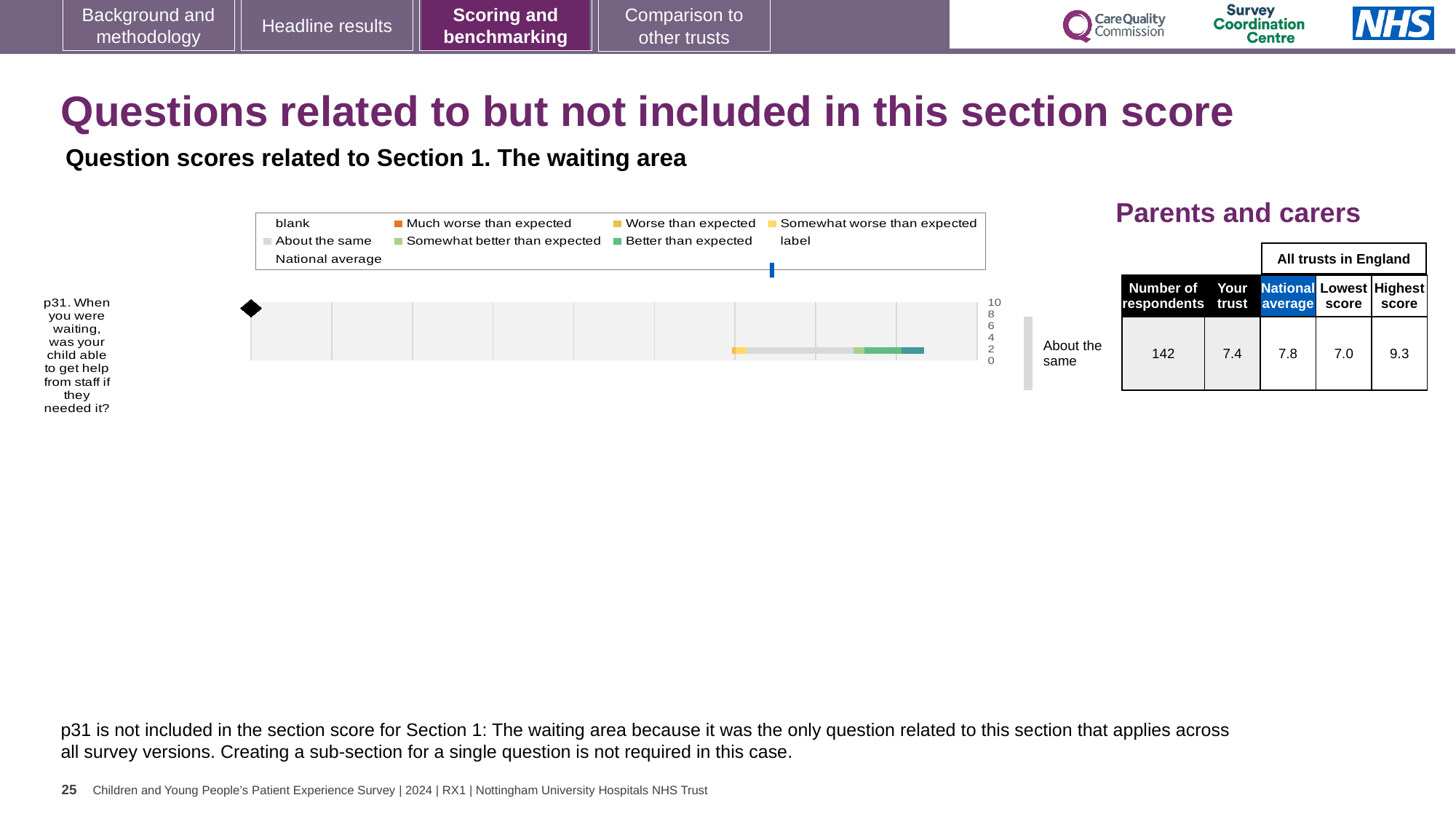
What is the difference between the national average and the 'Your trust' score for p31? 0.4 What is the 'Your trust' score for p31? 7.4 How many respondents answered p31? 142 How many questions are plotted in the chart? 1 What is the national average score for p31? 7.8 What is the difference between the highest and lowest scores for p31? 2.3 What benchmark category label is shown next to the chart for p31? About the same Which is larger for p31, the 'Your trust' score or the national average? National average What is the highest score among all trusts in England for p31? 9.3 What kind of chart is shown for question p31? bar chart What is the lowest score among all trusts in England for p31? 7.0 What is the maximum value shown on the chart's axis? 10